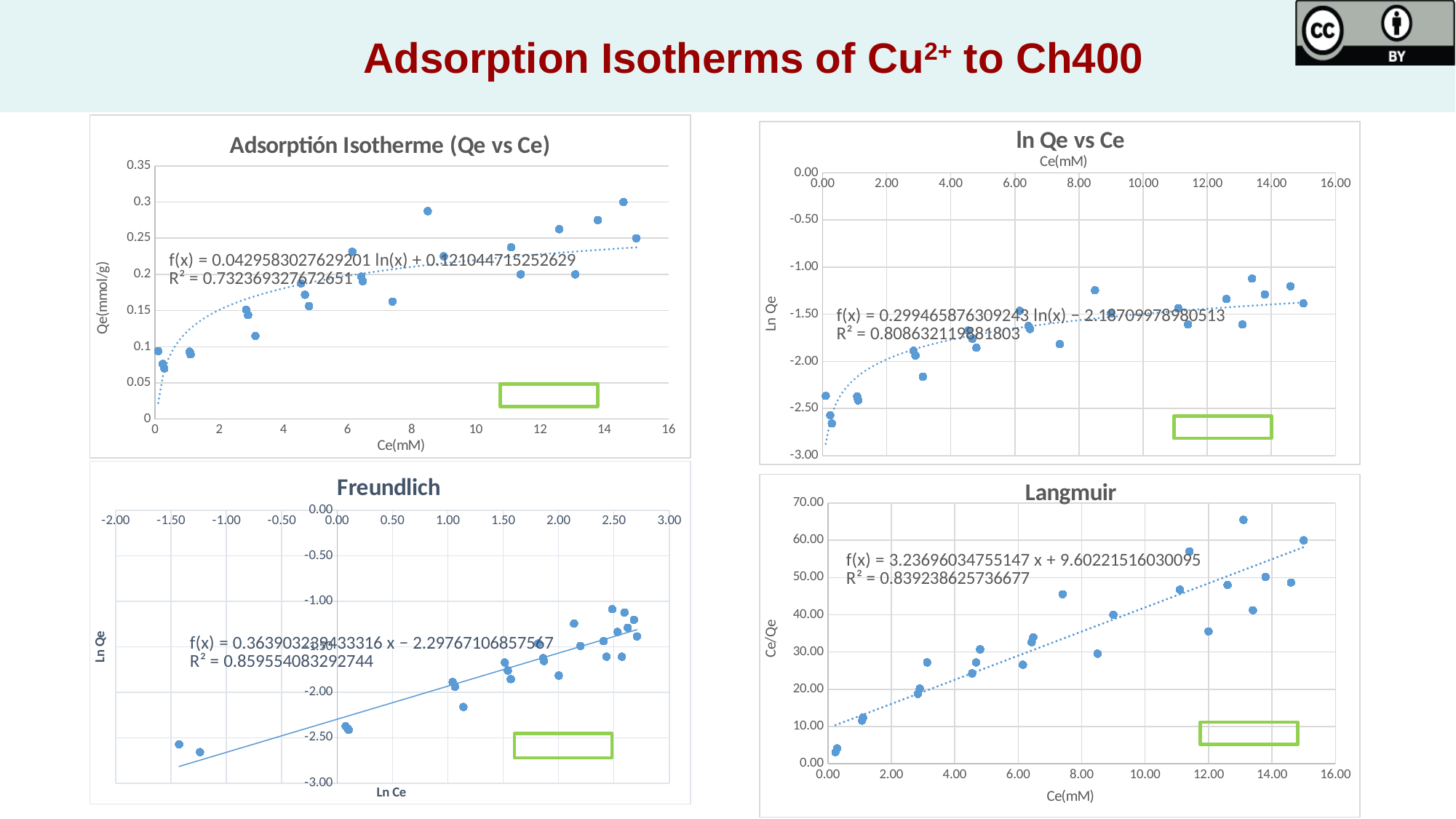
What kind of chart is the 'Langmuir' chart? scatter chart In the 'Langmuir' chart, is the lowest plotted Ce/Qe value greater or less than 10.00? less In the 'Langmuir' chart, is the highest plotted Ce/Qe value greater or less than 60.00? greater What is the y-axis label of the 'Langmuir' chart? Ce/Qe In the 'ln Qe vs Ce' chart, is the lowest plotted Ln Qe value greater or less than -2.50? less In the 'Adsorption Isotherme (Qe vs Ce)' chart, do the Qe values generally rise or fall as Ce increases? rise In the 'Langmuir' chart, do the Ce/Qe values generally rise or fall as Ce increases? rise What R² value is shown on the 'Freundlich' chart? 0.859554083292744 What kind of chart is the 'Adsorption Isotherme (Qe vs Ce)' chart? scatter chart In the 'Freundlich' chart, do the Ln Qe values generally rise or fall as Ln Ce increases? rise